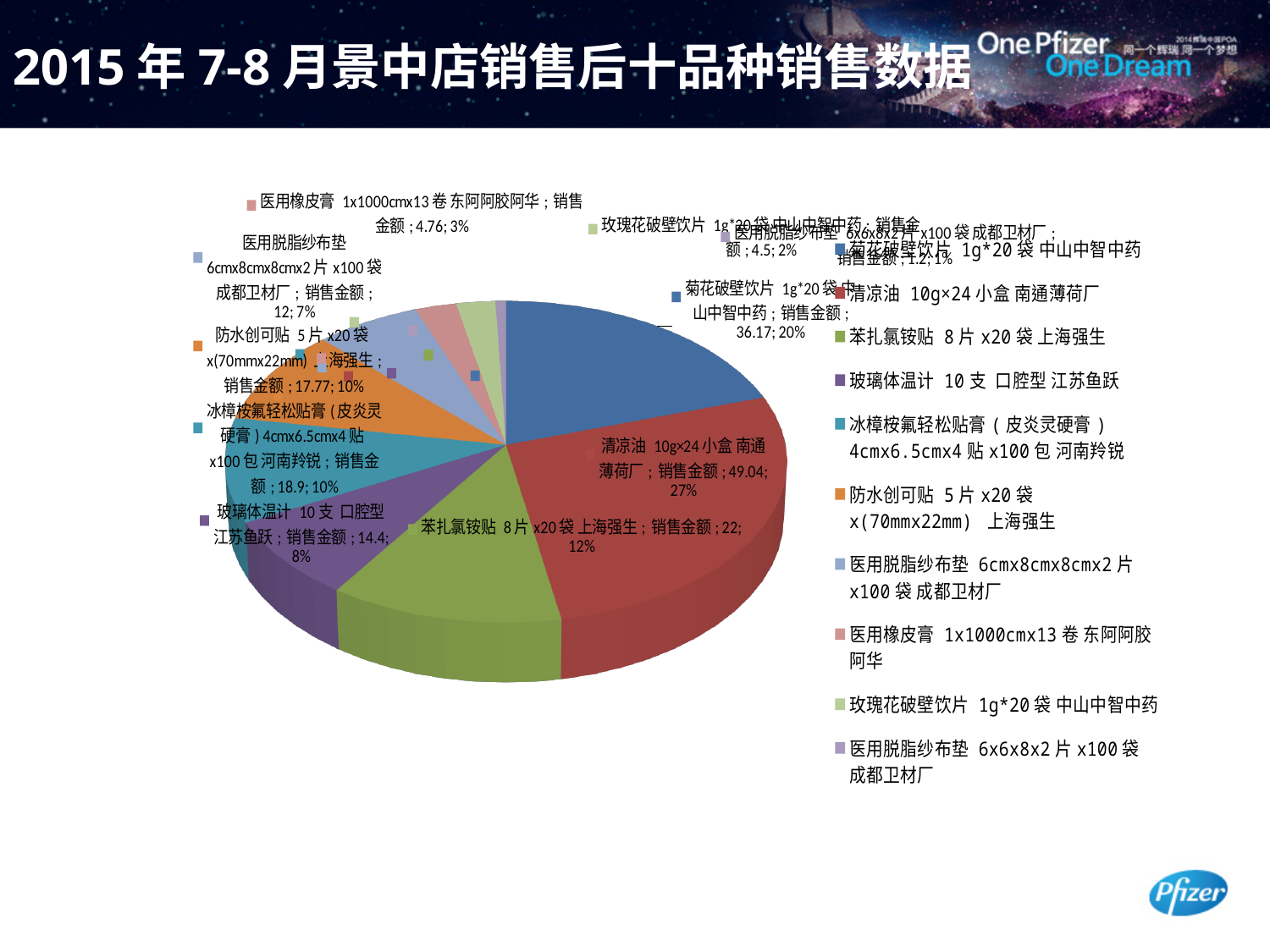
Which category has the largest slice of the pie? 清凉油 10g×24小盒 南通薄荷厂 What share of the pie does 菊花破壁饮片 1g*20袋 中山中智中药 account for? 20% Which category has the smallest slice of the pie? 医用脱脂纱布垫 6x6x8x2片 x100袋 成都卫材厂 How many categories does the pie chart have? 10 Which has a larger sales amount, 冰樟桉氟轻松贴膏(皮炎灵硬膏) 4cmx6.5cmx4贴 x100包 河南羚锐 or 防水创可贴 5片x20袋 x(70mmx22mm) 上海强生? 冰樟桉氟轻松贴膏(皮炎灵硬膏) 4cmx6.5cmx4贴 x100包 河南羚锐 What share of the pie does 医用脱脂纱布垫 6cmx8cmx8cmx2片 x100袋 成都卫材厂 account for? 7% What is the sales amount (销售金额) for 清凉油 10g×24小盒 南通薄荷厂? 49.04 What is the sales amount (销售金额) for 苯扎氯铵贴 8片x20袋 上海强生? 22 What is the sales amount (销售金额) for 玻璃体温计 10支 口腔型 江苏鱼跃? 14.4 What is the difference in sales amount between 清凉油 10g×24小盒 南通薄荷厂 and 苯扎氯铵贴 8片x20袋 上海强生? 27.04 What is the sales amount (销售金额) for 菊花破壁饮片 1g*20袋 中山中智中药? 36.17 What kind of chart is shown on the slide? pie chart